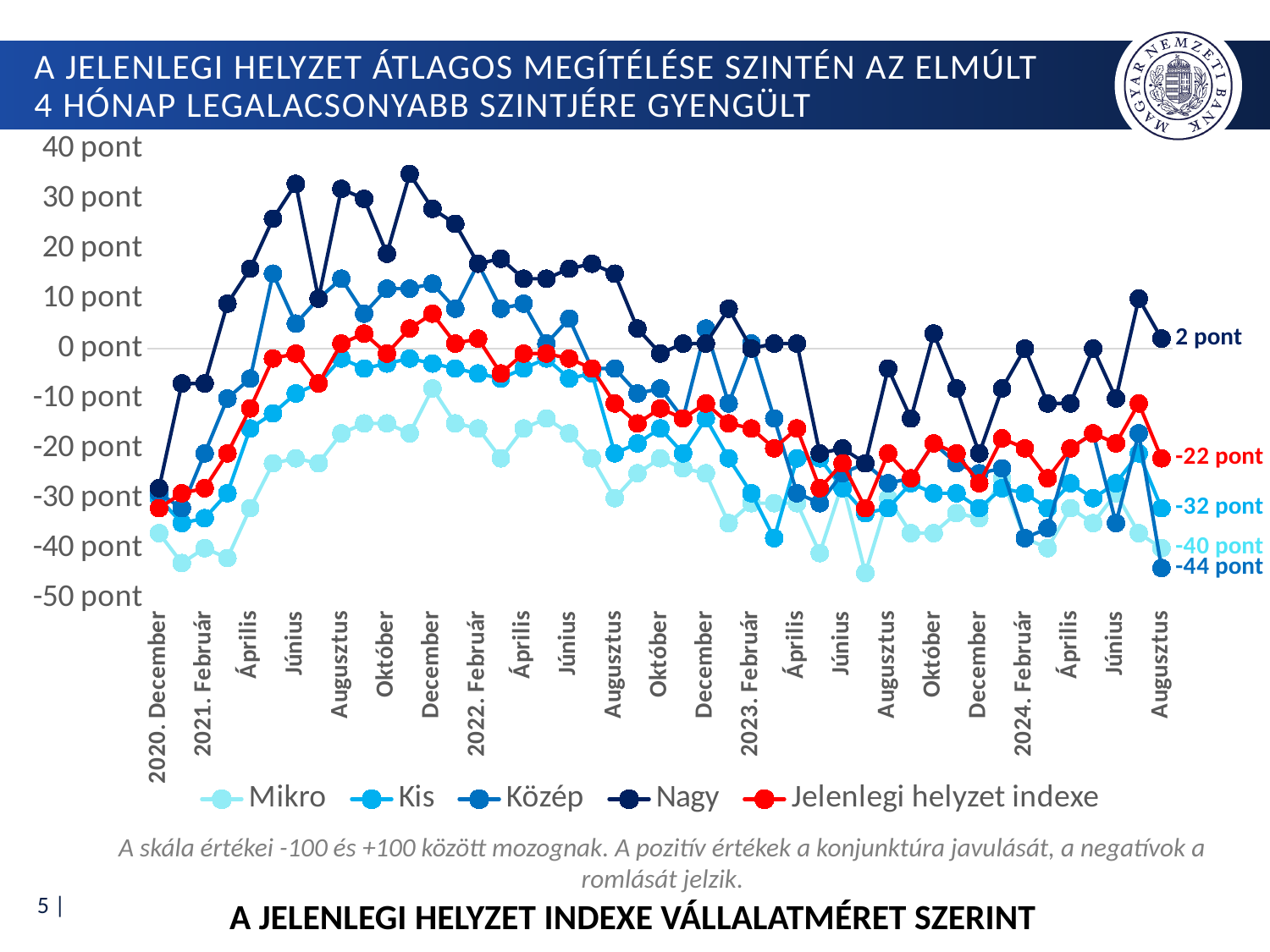
Is the value of the Nagy series in 2021 Június greater or less than 30 pont? greater What is the value of the Kis series at the last data point (2024 Augusztus)? -32 pont Which series has the lowest value at the last data point (2024 Augusztus)? Közép What is the value of the Mikro series at the last data point (2024 Augusztus)? -40 pont How many series does the legend list? 5 What is the value of the Közép series at the last data point (2024 Augusztus)? -44 pont Which series has the highest value at the last data point (2024 Augusztus)? Nagy What type of chart is shown on the slide? line chart What is the difference between the Nagy value and the Jelenlegi helyzet indexe value at the last data point (2024 Augusztus)? 24 pont Which series is drawn in red? Jelenlegi helyzet indexe What is the value of the Jelenlegi helyzet indexe series at the last data point (2024 Augusztus)? -22 pont What is the value of the Nagy series in 2024 Augusztus, as labelled at the end of the line? 2 pont